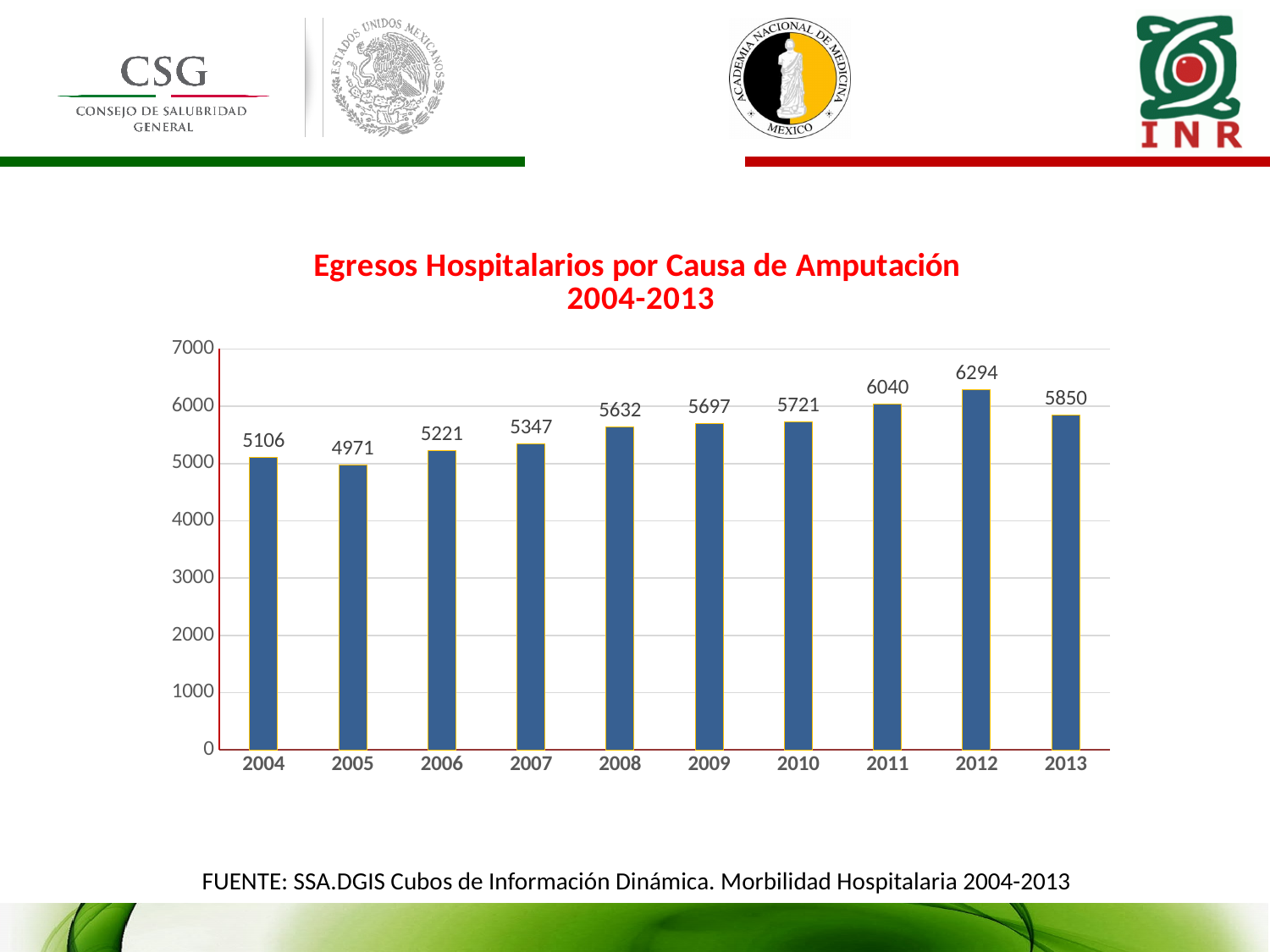
What is the value for 2004? 5106 How many years are shown on the x axis? 10 Is the value for 2011 greater or less than 6000? greater Which is larger, the value for 2008 or the value for 2010? 2010 Which year has the highest value? 2012 What is the difference between the values for 2005 and 2004? 135 Which year has the lowest value? 2005 What is the title of the chart? Egresos Hospitalarios por Causa de Amputación 2004-2013 What is the difference between the values for 2012 and 2013? 444 What is the value for 2013? 5850 What kind of chart is shown? Bar chart What is the value for 2011? 6040